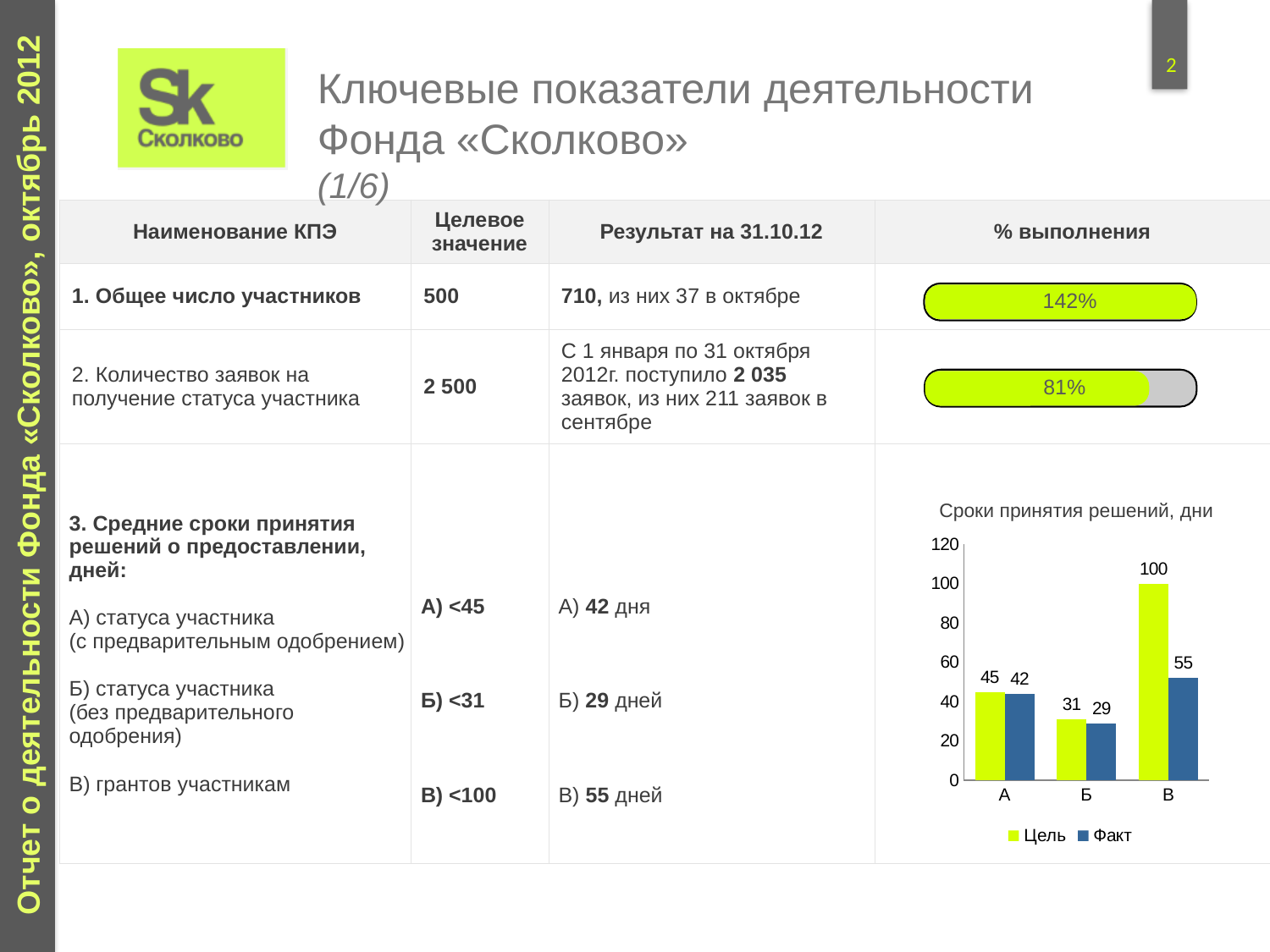
How many categories are shown on the x axis of the bar chart? 3 In the bar chart, which is larger for category А: Цель or Факт? Цель Which category has the lowest Факт value in the bar chart? Б What is the value of Факт for category В in the bar chart? 55 What is the value of Факт for category Б in the bar chart? 29 What is the value of Цель for category В in the bar chart? 100 What type of chart is shown on the slide? bar chart Which category has the highest Цель value in the bar chart? В What is the difference between Цель and Факт for category В in the bar chart? 45 How many series does the legend of the bar chart list? 2 What is the title of the bar chart on the slide? Сроки принятия решений, дни What is the value of Цель for category А in the bar chart? 45